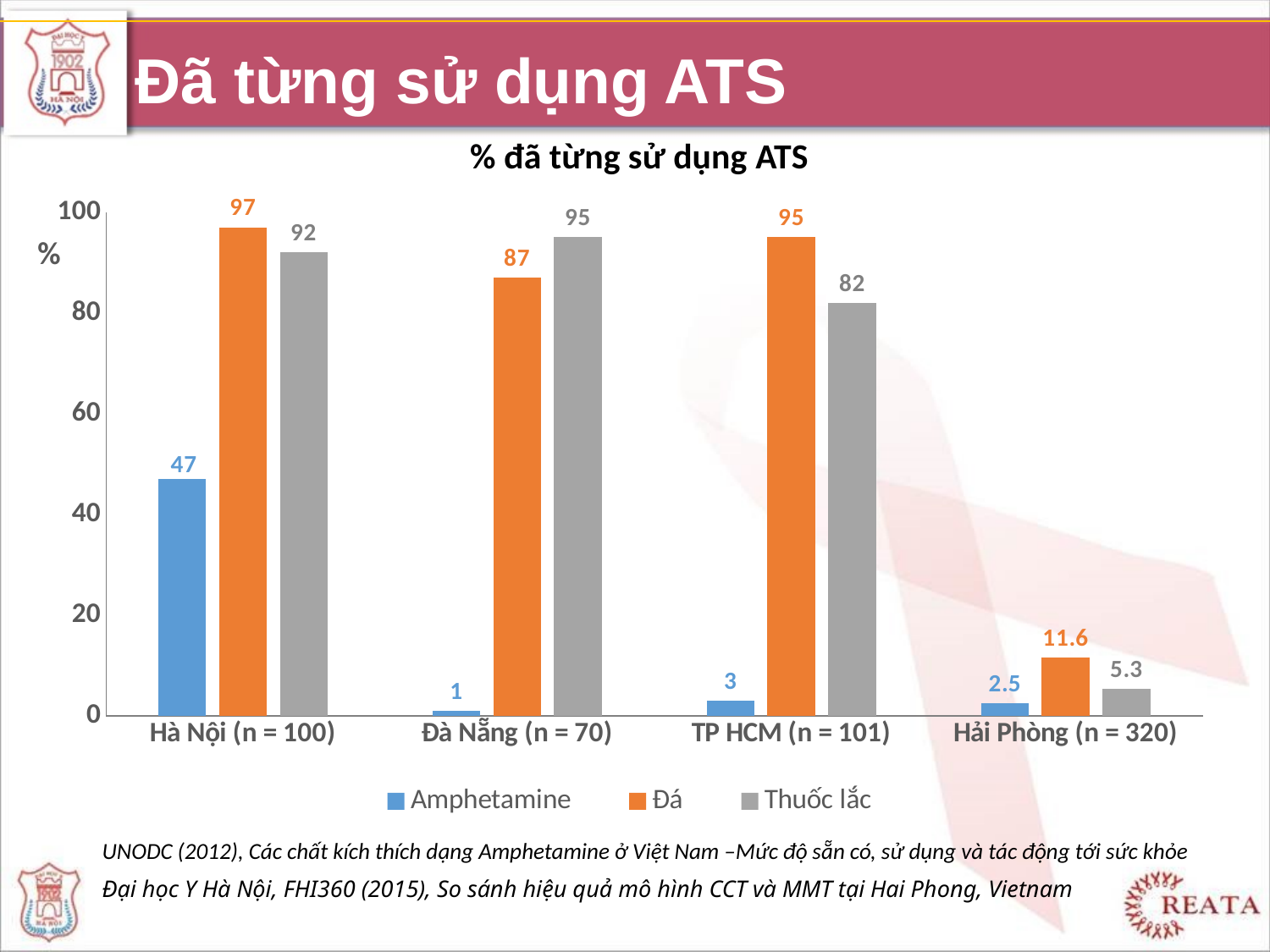
What is the value for Đá in Hải Phòng (n = 320)? 11.6 What is the value for Amphetamine in Hà Nội (n = 100)? 47 What is the value for Thuốc lắc in TP HCM (n = 101)? 82 What is the title of the chart? % đã từng sử dụng ATS What is the difference between the Đá and Thuốc lắc values in TP HCM (n = 101)? 13 Which is larger in Đà Nẵng (n = 70): Đá or Thuốc lắc? Thuốc lắc How many categories are shown on the x axis? 4 What kind of chart is shown on the slide? Bar chart Which category has the highest value for Đá? Hà Nội (n = 100) Which category has the lowest value for Amphetamine? Đà Nẵng (n = 70) What is the value for Đá in Đà Nẵng (n = 70)? 87 How many series does the legend list? 3